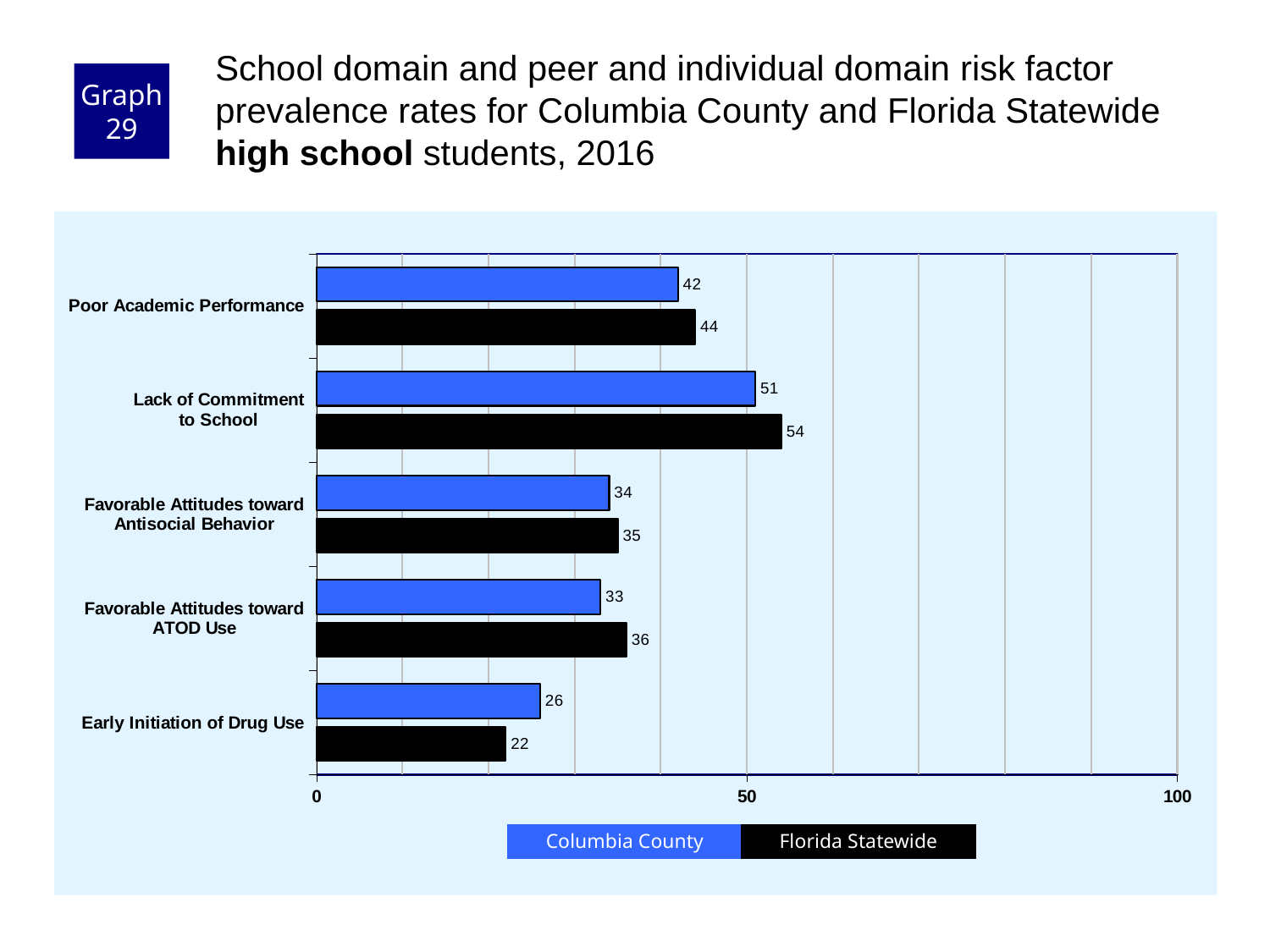
What is the Florida Statewide value for Lack of Commitment to School? 54 How many series does the legend list? 2 What is the difference between the Columbia County and Florida Statewide values for Early Initiation of Drug Use? 4 What is the difference between the Florida Statewide and Columbia County values for Lack of Commitment to School? 3 For Favorable Attitudes toward ATOD Use, which is larger: the Columbia County value or the Florida Statewide value? Florida Statewide What kind of chart is shown on the slide? Bar chart What is the Columbia County value for Poor Academic Performance? 42 What is the Columbia County value for Early Initiation of Drug Use? 26 What is the Florida Statewide value for Favorable Attitudes toward ATOD Use? 36 Which risk factor has the highest Columbia County value? Lack of Commitment to School How many risk factors are shown on the chart? 5 Which risk factor has the lowest Florida Statewide value? Early Initiation of Drug Use